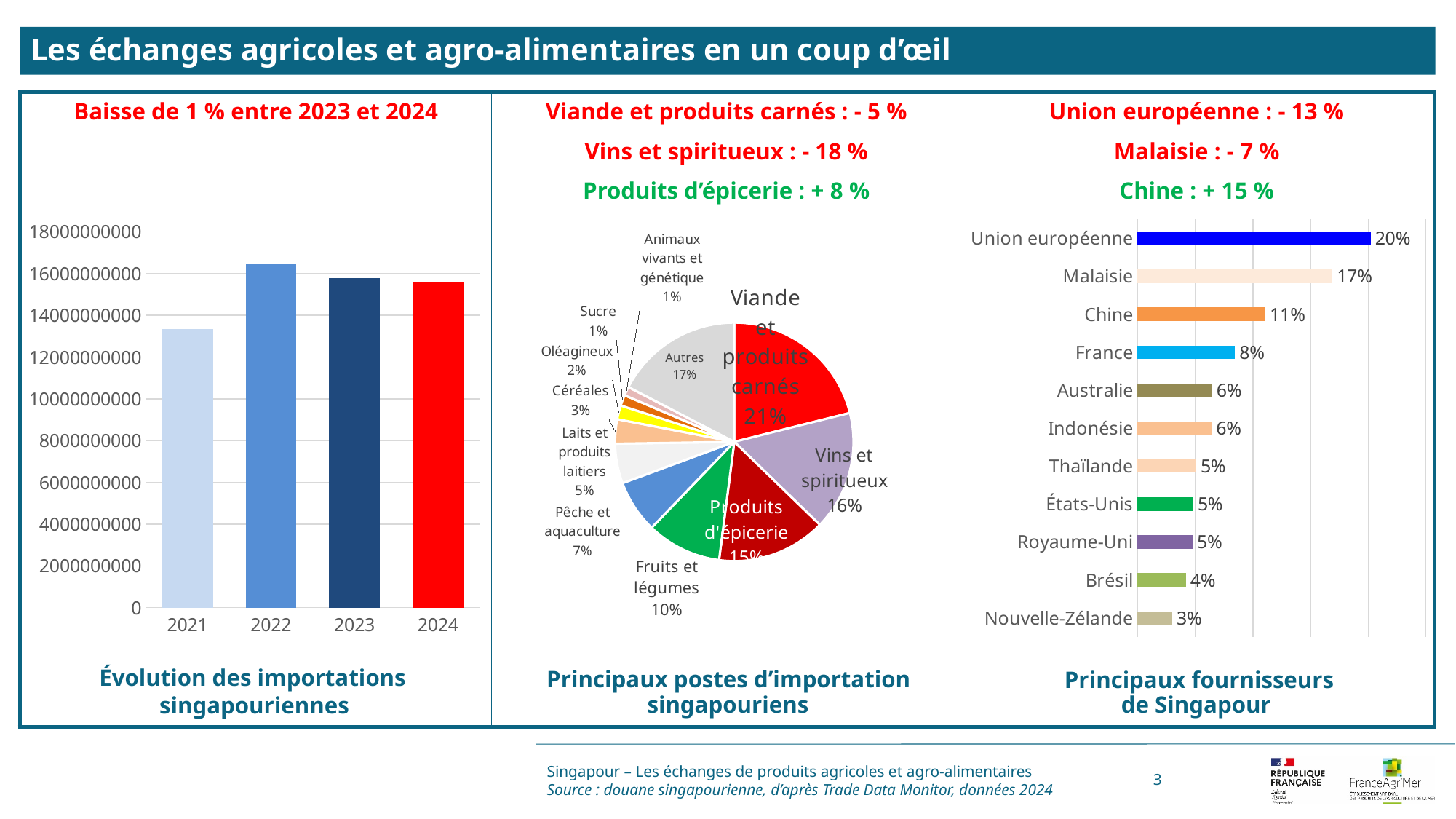
In the pie chart 'Principaux postes d'importation singapouriens', what share does 'Vins et spiritueux' have? 16% In the chart 'Évolution des importations singapouriennes', is the value for 2022 greater or less than 16000000000? greater In the chart 'Évolution des importations singapouriennes', what kind of chart is shown? bar chart In the chart 'Principaux fournisseurs de Singapour', which supplier has the lowest value? Nouvelle-Zélande In the chart 'Principaux fournisseurs de Singapour', what is the difference between Union européenne and Malaisie? 3 percentage points In the pie chart 'Principaux postes d'importation singapouriens', which category has the largest slice? Viande et produits carnés In the chart 'Évolution des importations singapouriennes', which year has the lowest bar? 2021 In the chart 'Principaux fournisseurs de Singapour', what is the value for Chine? 11% In the pie chart 'Principaux postes d'importation singapouriens', what is the share of 'Fruits et légumes'? 10% In the chart 'Évolution des importations singapouriennes', is the value for 2021 greater or less than 14000000000? less In the chart 'Évolution des importations singapouriennes', which year has the highest bar? 2022 In the chart 'Évolution des importations singapouriennes', how many years are plotted? 4